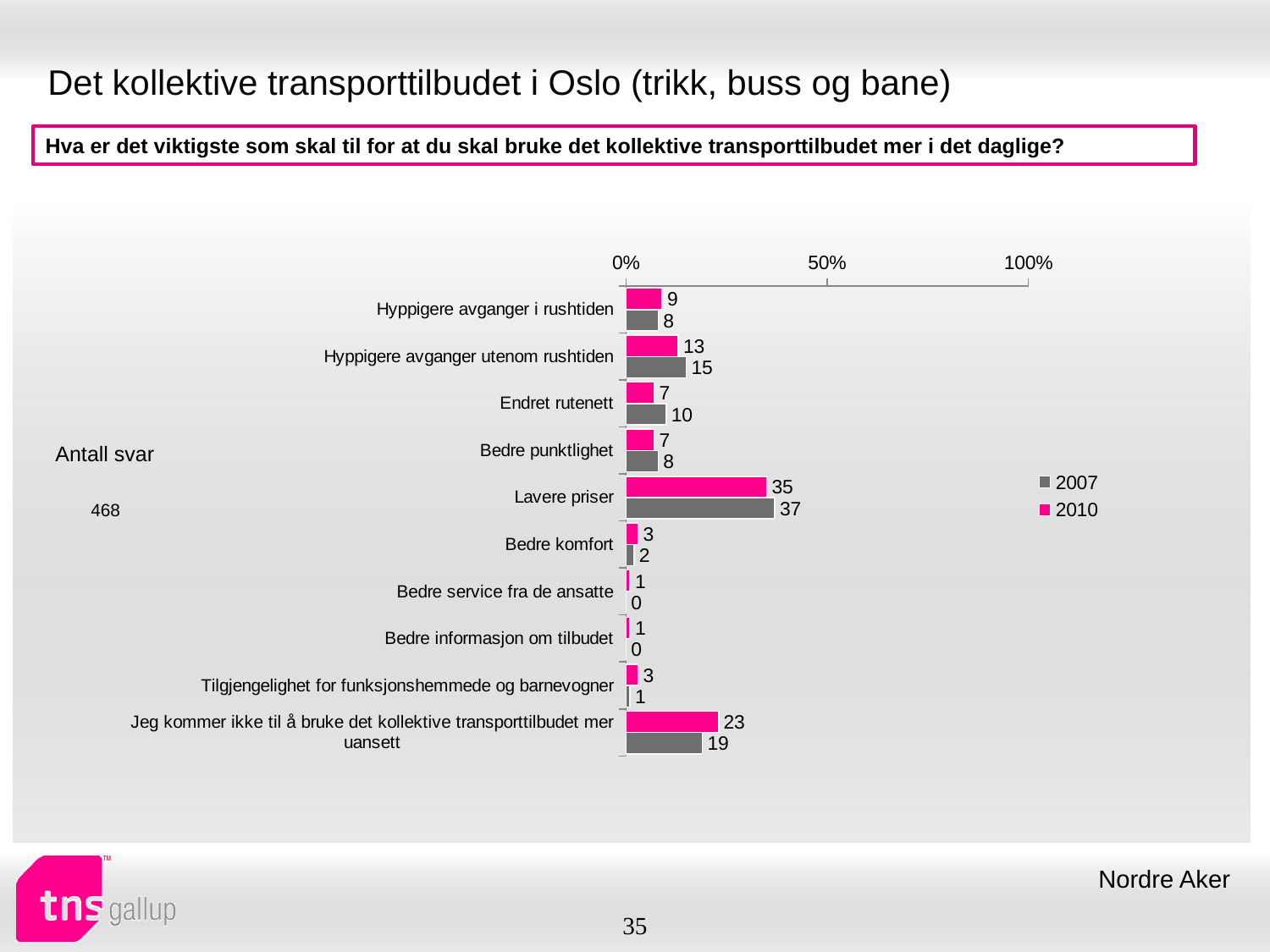
What is the 2007 value for "Endret rutenett"? 10 How many categories are shown on the chart? 10 Which is larger for "Endret rutenett": the 2007 value or the 2010 value? 2007 How many series does the legend list? 2 Which category has the highest 2010 value? Lavere priser What is the difference between the 2007 and 2010 values for "Jeg kommer ikke til å bruke det kollektive transporttilbudet mer uansett"? 4 Which category has the highest 2007 value? Lavere priser Which colour represents the 2010 series in the legend? Pink What kind of chart is shown on the slide? Bar chart Is the 2007 value for "Lavere priser" greater or less than 50%? less What is the 2007 value for "Hyppigere avganger utenom rushtiden"? 15 What is the 2010 value for "Lavere priser"? 35